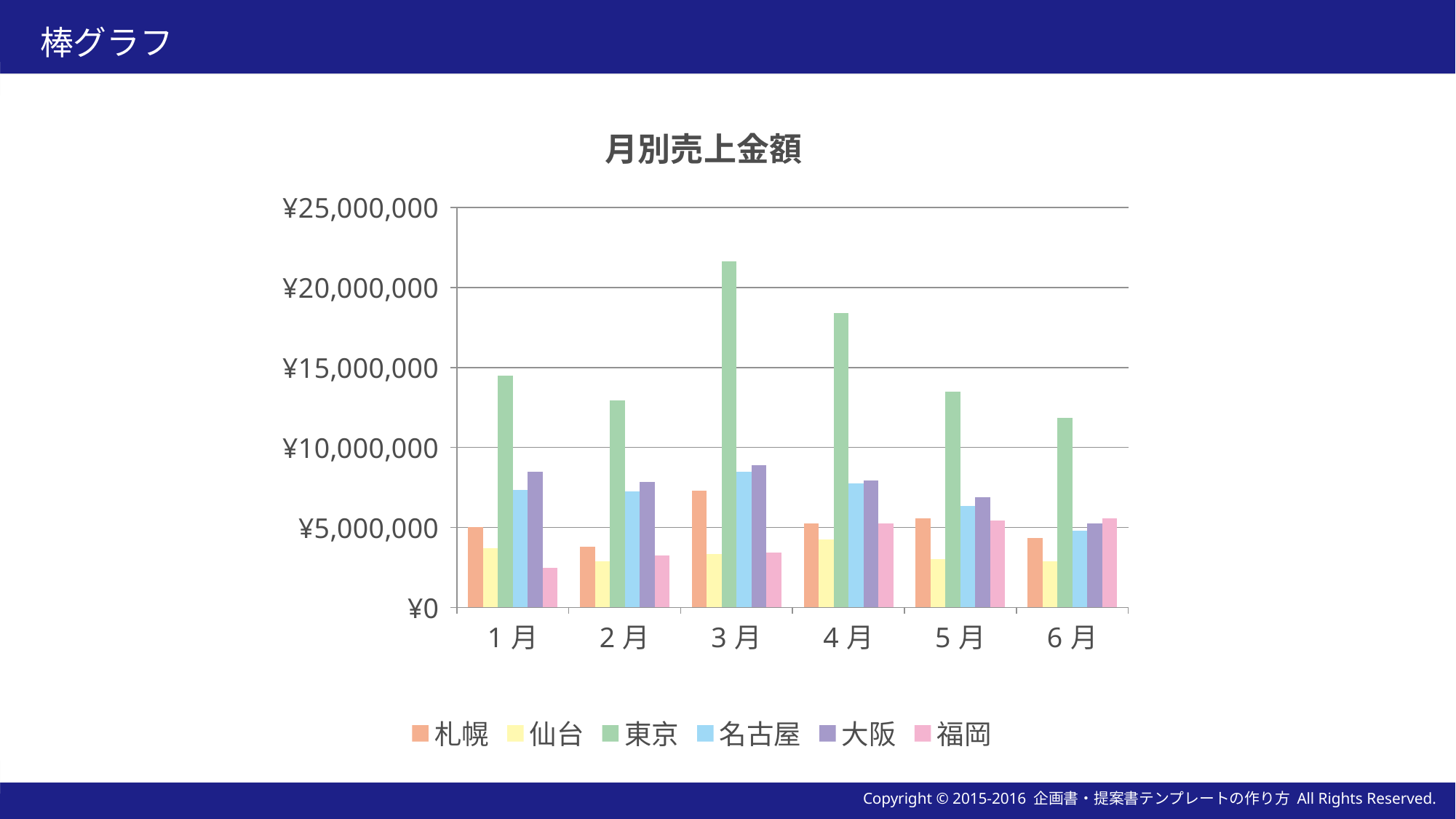
In which month is the value for 東京 the highest? 3月 In 1月, which is larger, the value for 東京 or the value for 大阪? 東京 Is the value for 東京 in 4月 greater or less than ¥20,000,000? less Is the value for 東京 in 3月 greater or less than ¥20,000,000? greater What is the title of the chart? 月別売上金額 Which city has the highest value in 3月? 東京 In which month is the value for 東京 the lowest? 6月 Is the value for 札幌 in 3月 greater or less than ¥5,000,000? greater What kind of chart is shown on the slide? Bar chart How many series does the legend list? 6 How many months are shown on the x axis? 6